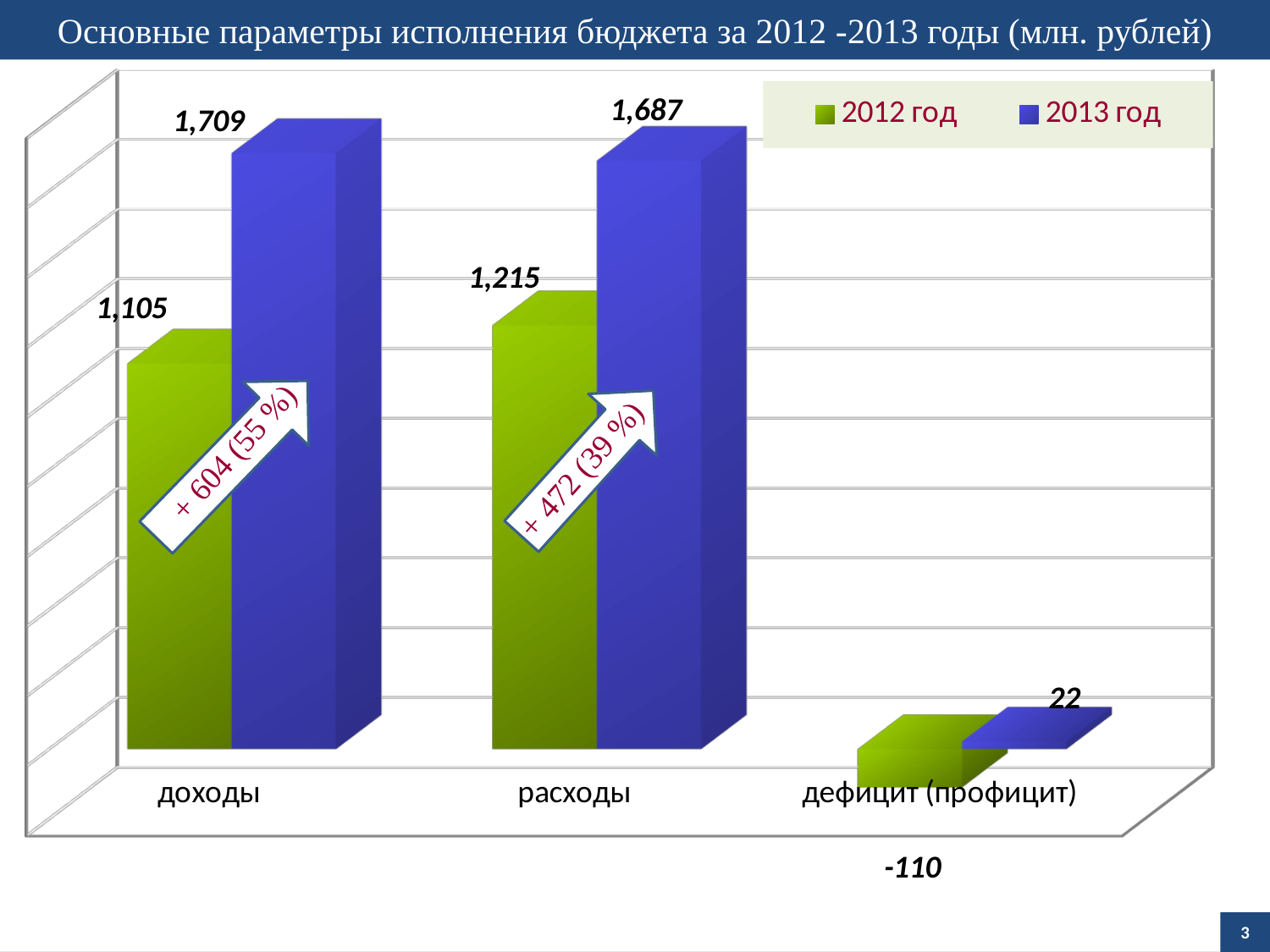
What is the value for расходы in 2012 год? 1,215 Which category has the lowest value in the 2012 год series? дефицит (профицит) What is the value for дефицит (профицит) in 2013 год? 22 What is the value for доходы in 2013 год? 1,709 What is the difference between the 2013 год and 2012 год values for доходы? 604 How many series does the legend list? 2 What kind of chart is shown on the slide? bar chart What is the value for расходы in 2013 год? 1,687 What is the value for доходы in 2012 год? 1,105 Which category has the highest value in the 2013 год series? доходы Which is larger: расходы in 2012 год or доходы in 2012 год? расходы in 2012 год What is the value for дефицит (профицит) in 2012 год? -110